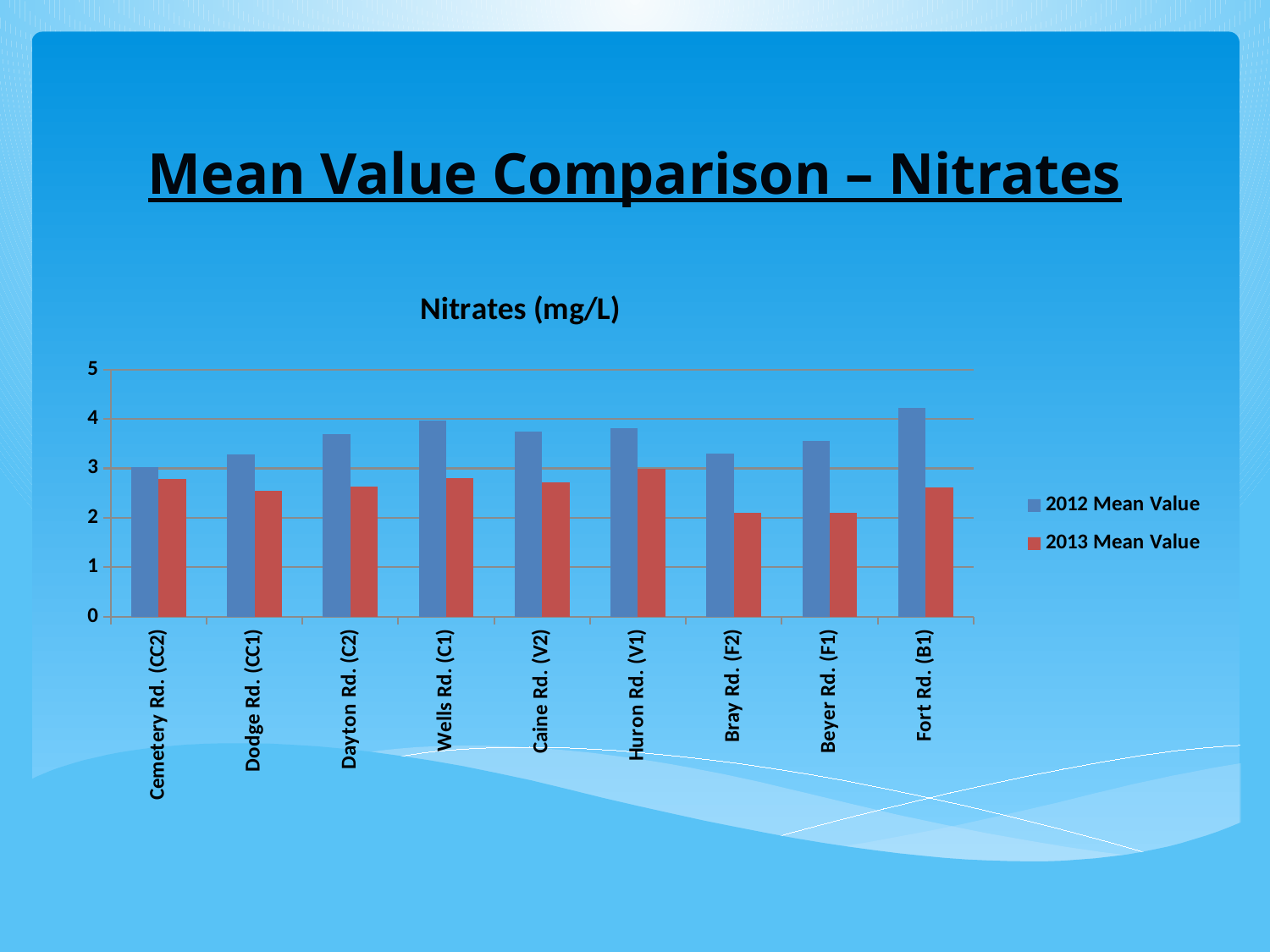
Which site has the lowest 2012 Mean Value? Cemetery Rd. (CC2) What is the title of the chart? Nitrates (mg/L) For Wells Rd. (C1), which is larger: the 2012 Mean Value or the 2013 Mean Value? 2012 Mean Value What kind of chart is shown on the slide? bar chart Is the 2012 Mean Value for Dayton Rd. (C2) greater or less than 3? greater Is the 2013 Mean Value for Dodge Rd. (CC1) greater or less than 3? less How many series does the legend list? 2 Is the 2012 Mean Value for Fort Rd. (B1) greater or less than 4? greater Which series is shown in red? 2013 Mean Value How many sampling sites (categories) are shown on the x axis? 9 Which site has the highest 2013 Mean Value? Huron Rd. (V1) Which site has the highest 2012 Mean Value? Fort Rd. (B1)